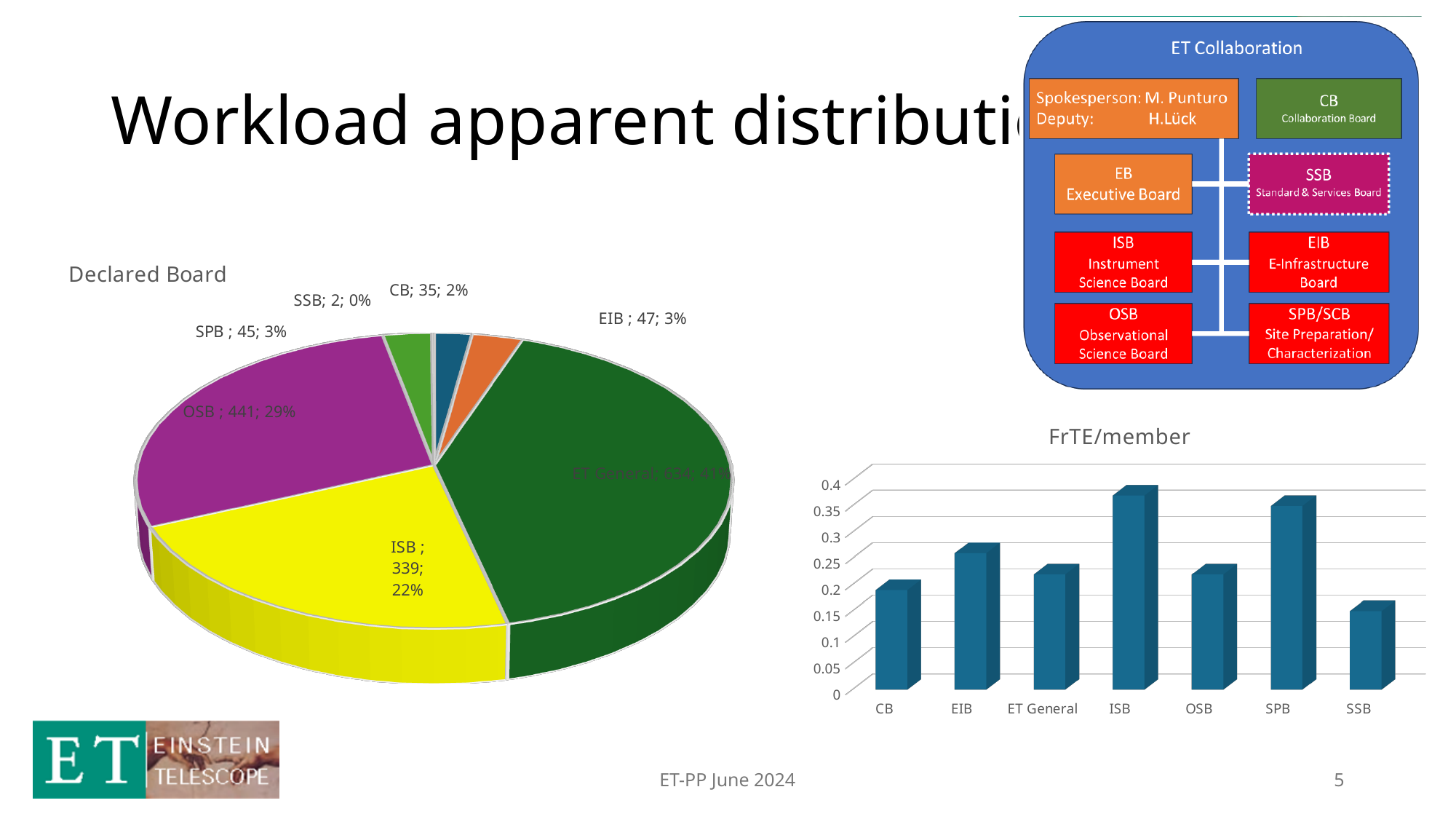
What kind of chart is the Declared Board chart? Pie chart In the Declared Board pie chart, which board has the smallest slice? SSB In the Declared Board pie chart, what value is shown for OSB? 441 In the Declared Board pie chart, how many slices are there? 7 In the Declared Board pie chart, what value is shown for ISB? 339 In the Declared Board pie chart, which board has the largest slice? ET General What kind of chart is the FrTE/member chart? Bar chart In the Declared Board pie chart, what percentage share does ET General have? 41% In the Declared Board pie chart, what is the difference between the values for OSB and ISB? 102 In the FrTE/member chart, which category has the lowest value? SSB In the FrTE/member chart, is the value for ISB greater or less than 0.3? greater In the FrTE/member chart, is the value for SSB greater or less than 0.2? less